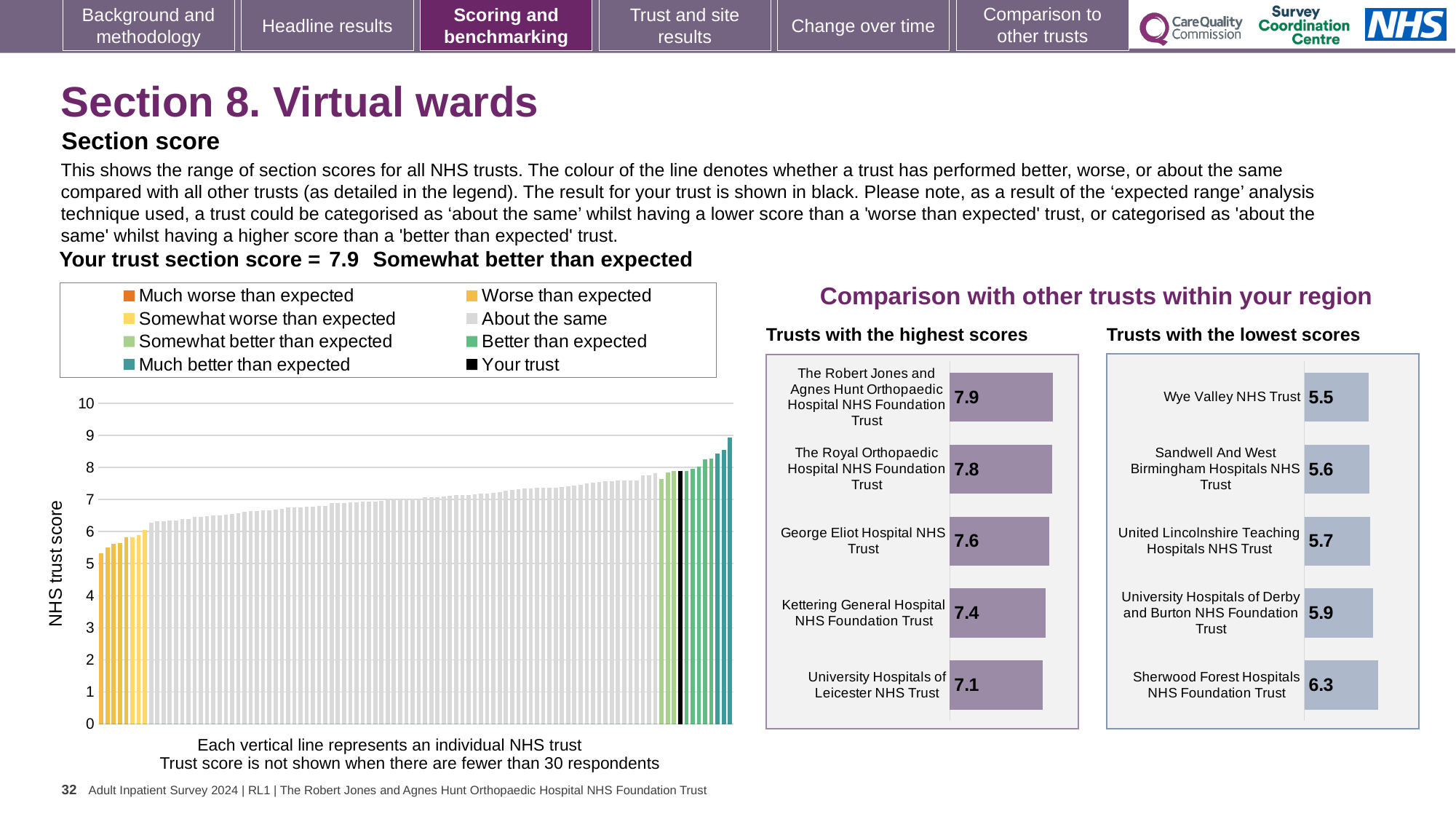
In the 'Trusts with the highest scores' chart, what is the difference between the scores of The Robert Jones and Agnes Hunt Orthopaedic Hospital NHS Foundation Trust and University Hospitals of Leicester NHS Trust? 0.8 In the 'Trusts with the lowest scores' chart, what is the difference between the scores of Sherwood Forest Hospitals NHS Foundation Trust and Wye Valley NHS Trust? 0.8 How many entries does the legend of the main NHS trust score chart list? 8 How many trusts are shown in the 'Trusts with the lowest scores' chart? 5 In the 'Trusts with the highest scores' chart, which has the higher score: Kettering General Hospital NHS Foundation Trust or The Royal Orthopaedic Hospital NHS Foundation Trust? The Royal Orthopaedic Hospital NHS Foundation Trust In the main NHS trust score chart on the left, do the bar heights rise or fall from left to right? Rise In the 'Trusts with the highest scores' chart, which trust has the highest score? The Robert Jones and Agnes Hunt Orthopaedic Hospital NHS Foundation Trust In the 'Trusts with the highest scores' chart, what is the score for George Eliot Hospital NHS Trust? 7.6 In the 'Trusts with the lowest scores' chart, what is the score for Wye Valley NHS Trust? 5.5 What kind of chart is the 'Trusts with the highest scores' chart? Bar chart In the 'Trusts with the lowest scores' chart, what is the score for University Hospitals of Derby and Burton NHS Foundation Trust? 5.9 In the 'Trusts with the lowest scores' chart, which trust has the lowest score? Wye Valley NHS Trust